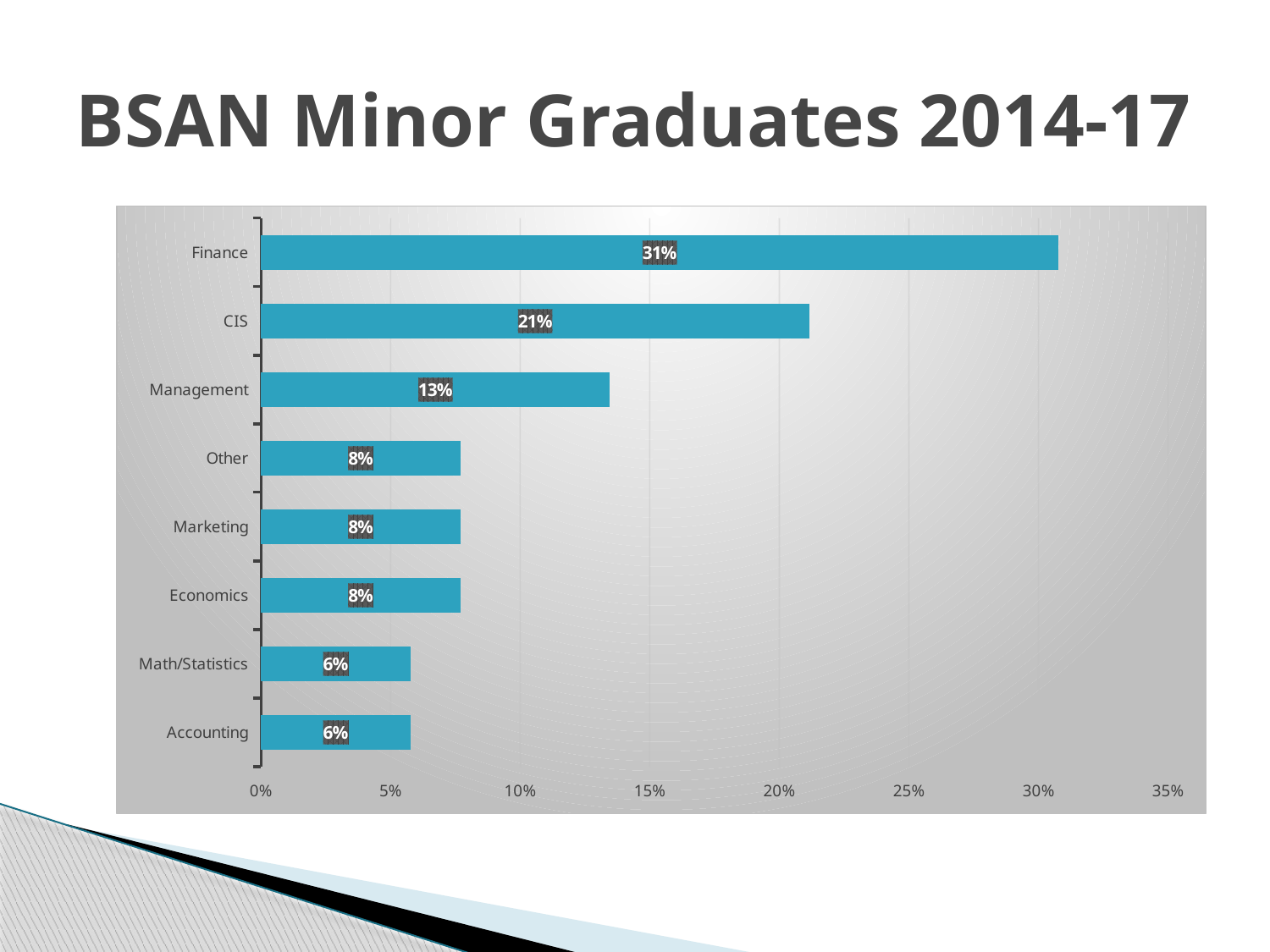
Which category has the highest value? Finance Is the value for Finance greater or less than 30%? greater Which is larger, the value for CIS or the value for Management? CIS How many categories are shown on the chart? 8 What is the value shown for CIS? 21% What is the value shown for Management? 13% What is the value shown for Accounting? 6% What is the difference between the Management and Marketing values? 5% What is the difference between the Finance and CIS values? 10% What percentage of BSAN minor graduates is shown for Finance? 31% What is the title of the slide? BSAN Minor Graduates 2014-17 What kind of chart is shown on the slide? Bar chart